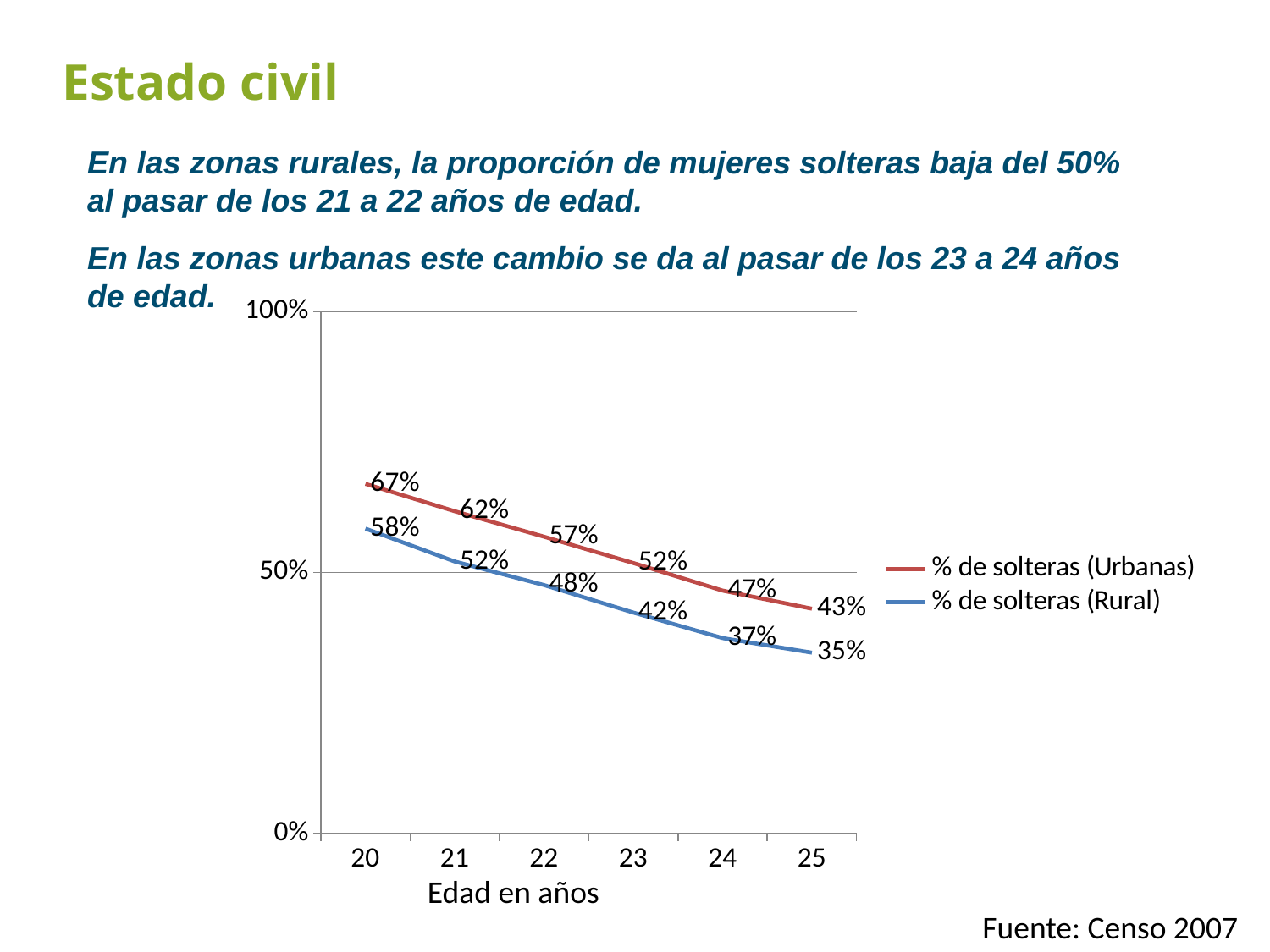
Do the values of % de solteras (Rural) rise or fall as age increases? fall What is the value of % de solteras (Urbanas) at age 20? 67% How many series does the legend list? 2 What is the value of % de solteras (Rural) at age 24? 37% At which age is % de solteras (Urbanas) highest? 20 At which age is % de solteras (Rural) lowest? 25 How many age points are plotted on the x axis? 6 What is the value of % de solteras (Urbanas) at age 25? 43% What kind of chart is shown? line chart What is the difference between % de solteras (Urbanas) and % de solteras (Rural) at age 23? 10% Which is larger at age 21: % de solteras (Urbanas) or % de solteras (Rural)? % de solteras (Urbanas) What is the value of % de solteras (Rural) at age 22? 48%